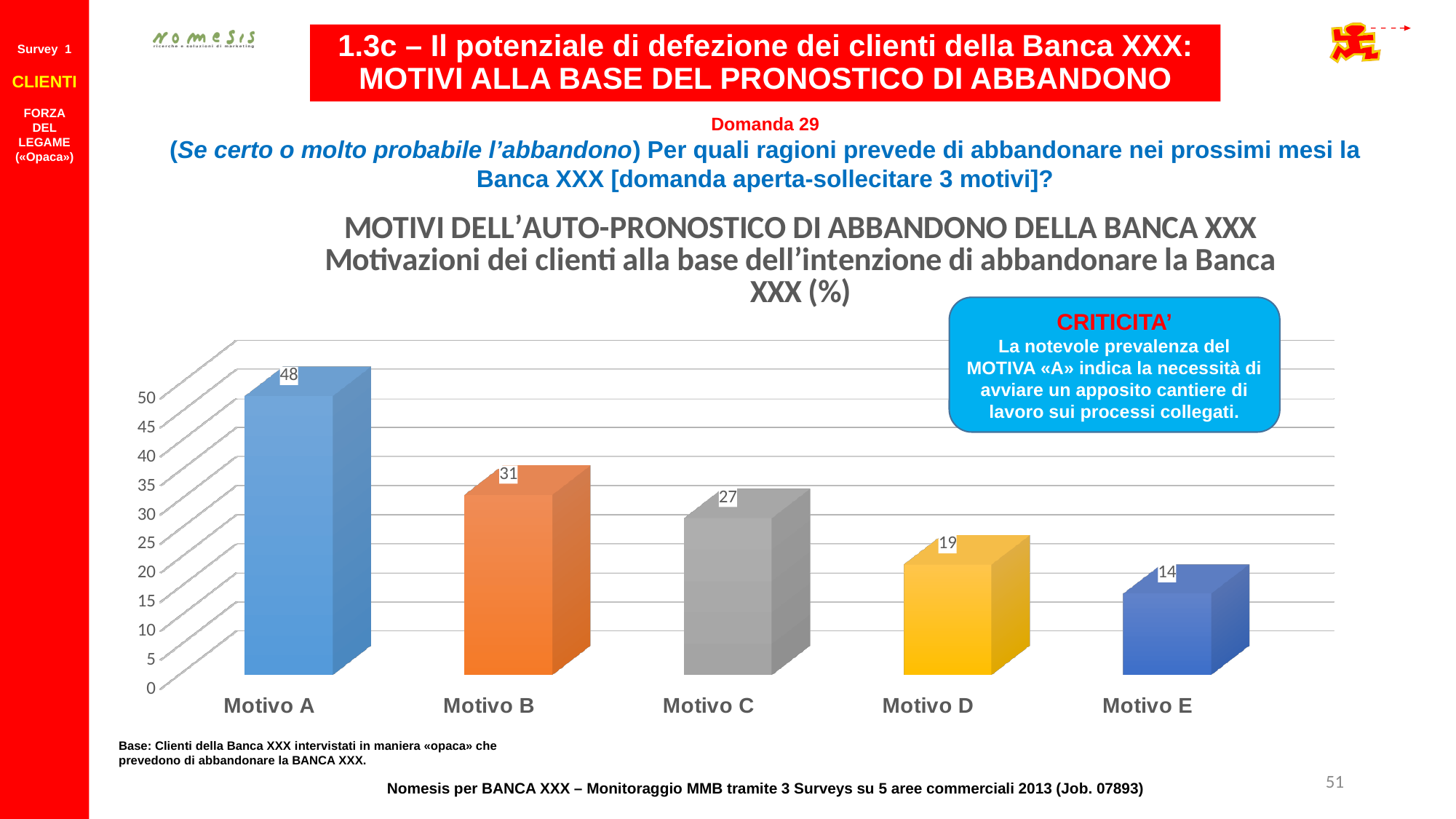
What kind of chart is shown on the slide? bar chart Which category has the highest value? Motivo A What is the difference between the values for Motivo A and Motivo B? 17 How many categories are shown on the x axis? 5 What is the difference between the values for Motivo D and Motivo E? 5 Which is larger, the value for Motivo B or the value for Motivo C? Motivo B Do the values rise or fall from Motivo A to Motivo E? fall What is the value for Motivo C? 27 What is the value for Motivo E? 14 What is the value for Motivo A? 48 Which category has the lowest value? Motivo E Is the value for Motivo D greater or less than 20? less